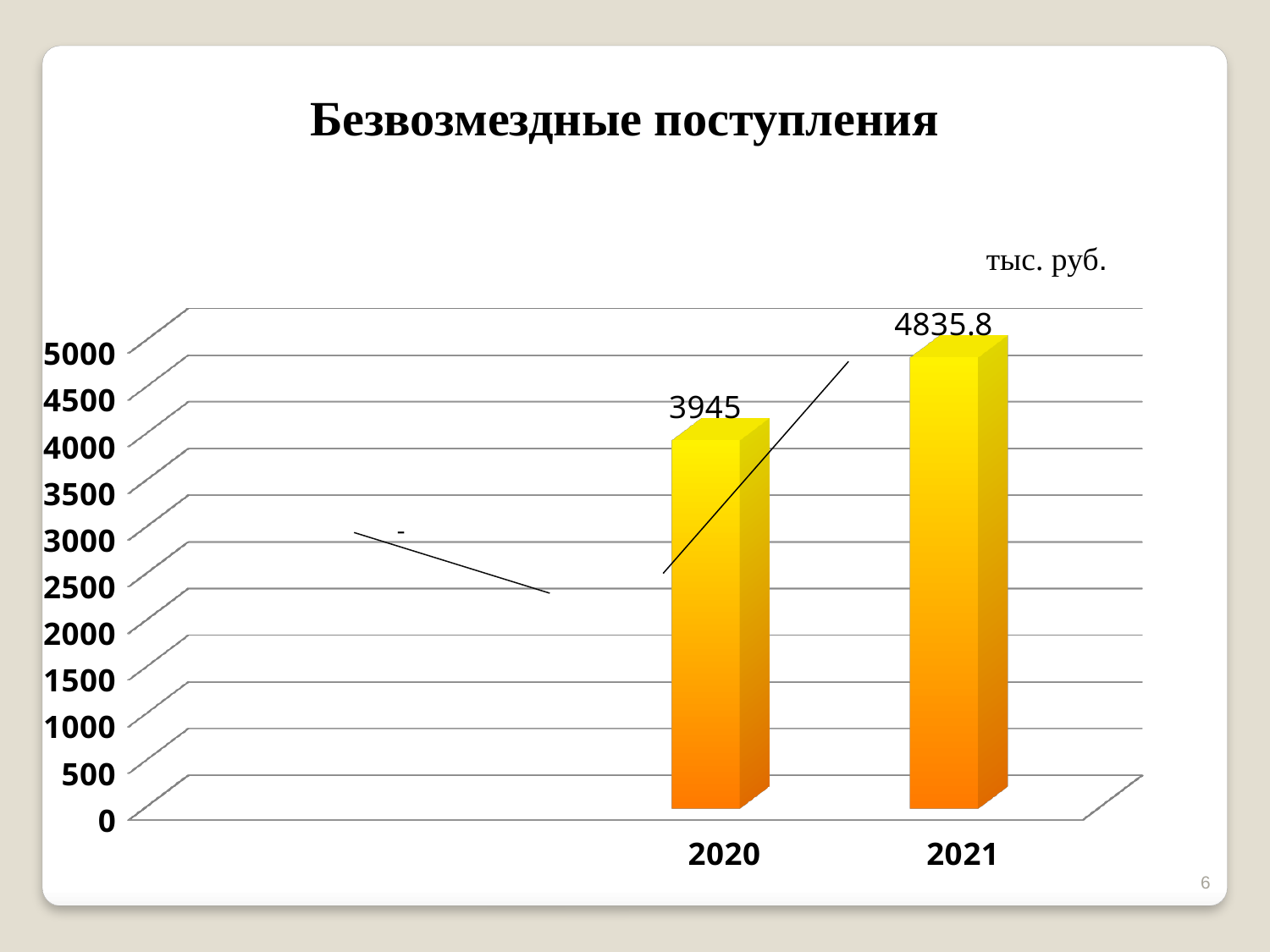
Which year has the lower value? 2020 What is the value for 2021? 4835.8 What is the value for 2020? 3945 What is the title of the chart? Безвозмездные поступления Is the value for 2020 larger or smaller than the value for 2021? smaller Is the value for 2021 greater or less than 5000? less Do the values rise or fall from 2020 to 2021? rise What kind of chart is shown? bar chart Is the value for 2020 greater or less than 3500? greater Which year has the higher value? 2021 What is the difference between the values for 2021 and 2020? 890.8 How many years are labelled on the x axis? 2